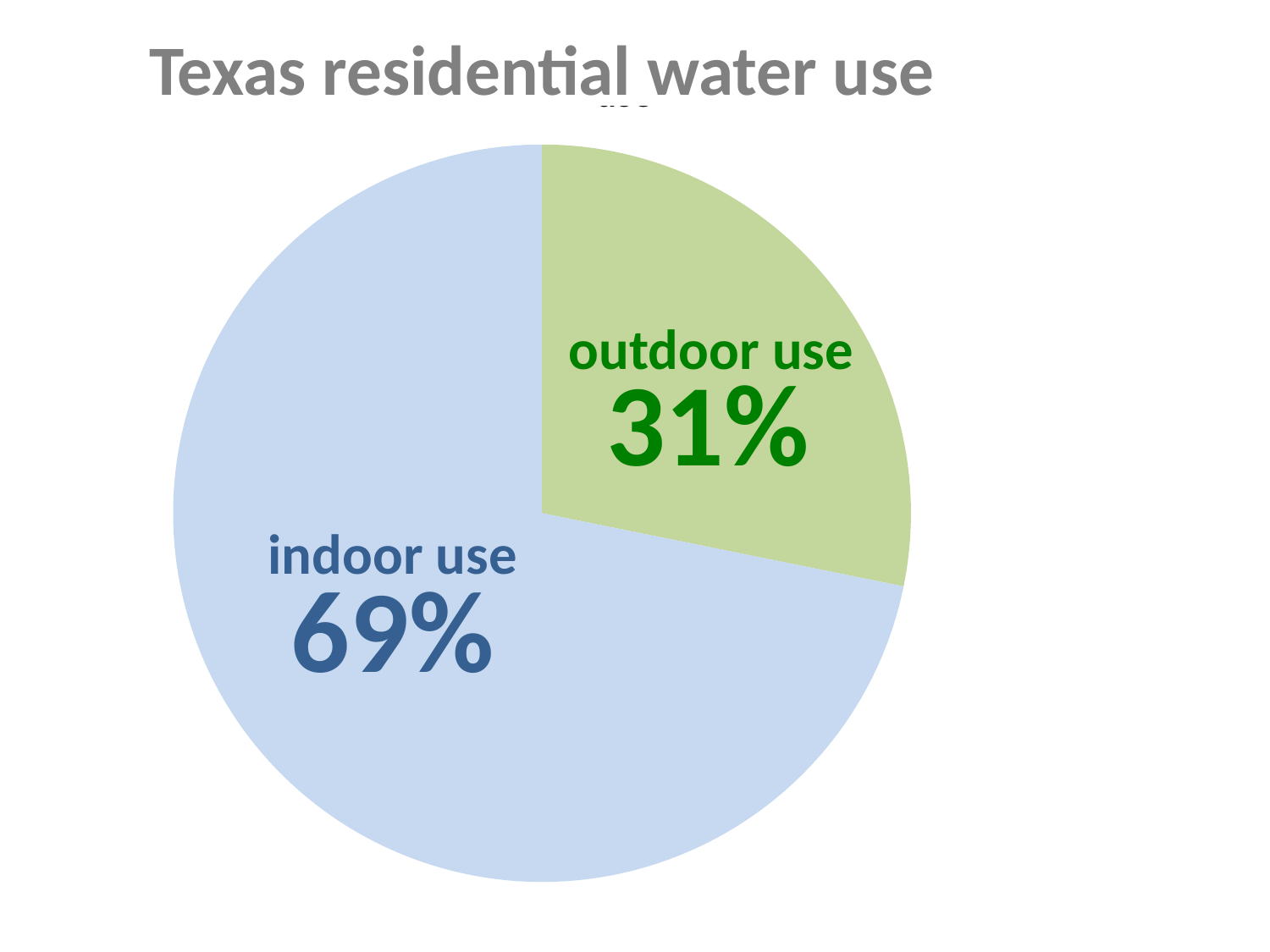
Which is larger, indoor use or outdoor use? indoor use What is the title of the chart? Texas residential water use What colour is the outdoor use slice? green What is the difference in percentage points between indoor use and outdoor use? 38 What share of Texas residential water use is outdoor use? 31% Which category has the smallest share of the pie? outdoor use What share of Texas residential water use is indoor use? 69% How many slices does the pie chart have? 2 Which category has the largest share of the pie? indoor use What kind of chart is shown on the slide? pie chart